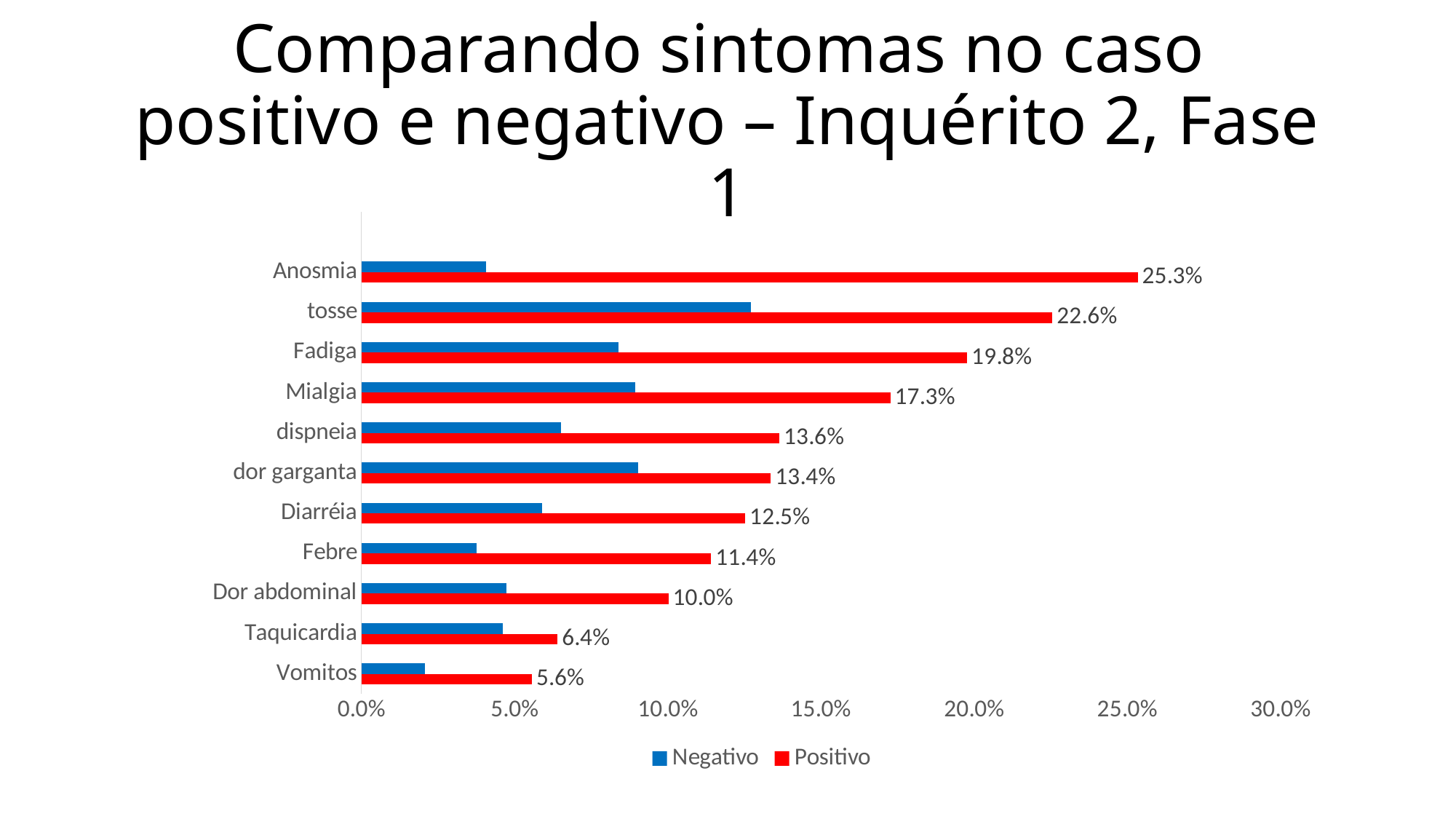
What is the Positivo value for Febre? 11.4% Which symptom has the lowest Positivo value? Vomitos How many series does the legend list? 2 Which symptom has the highest Negativo value? tosse Which is larger, the Positivo value for Febre or the Positivo value for Dor abdominal? Febre What is the Positivo value for Anosmia? 25.3% Is the Negativo value for Vomitos greater or less than 5.0%? less Which symptom has the highest Positivo value? Anosmia What is the difference between the Positivo values for Fadiga and Mialgia? 2.5% What is the Positivo value for Taquicardia? 6.4% Is the Negativo value for tosse greater or less than 10.0%? greater How many symptoms are shown on the chart? 11